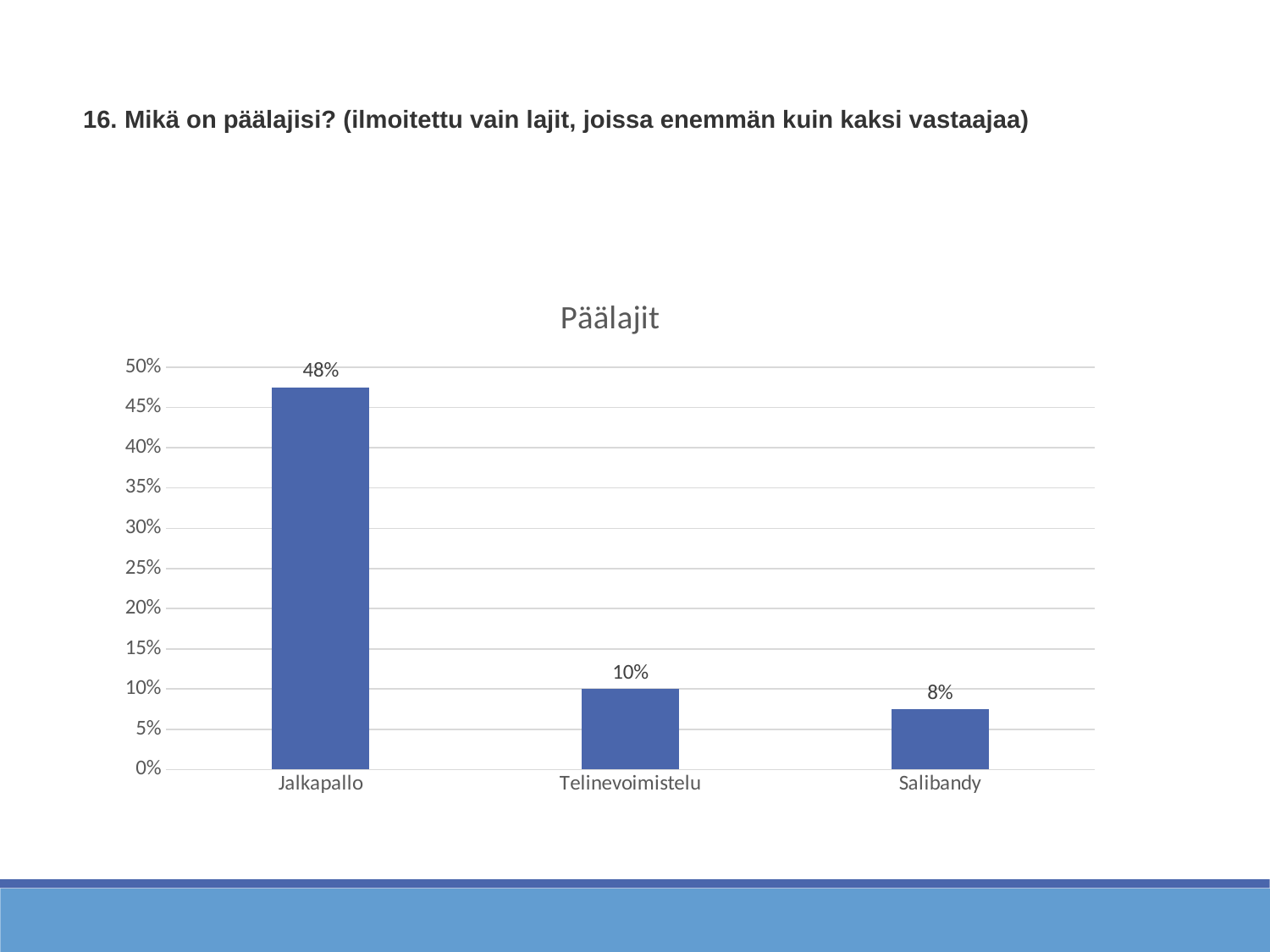
Which category has the lowest value? Salibandy What is the value for Salibandy? 8% What is the difference between the values for Jalkapallo and Telinevoimistelu? 38% Which category has the highest value? Jalkapallo What is the difference between the values for Telinevoimistelu and Salibandy? 2% How many categories are shown on the chart? 3 What kind of chart is shown on the slide? bar chart What is the value for Telinevoimistelu? 10% Which is larger, the value for Jalkapallo or the value for Salibandy? Jalkapallo What is the title of the chart? Päälajit What is the value for Jalkapallo? 48% Is the value for Jalkapallo greater or less than 40%? greater